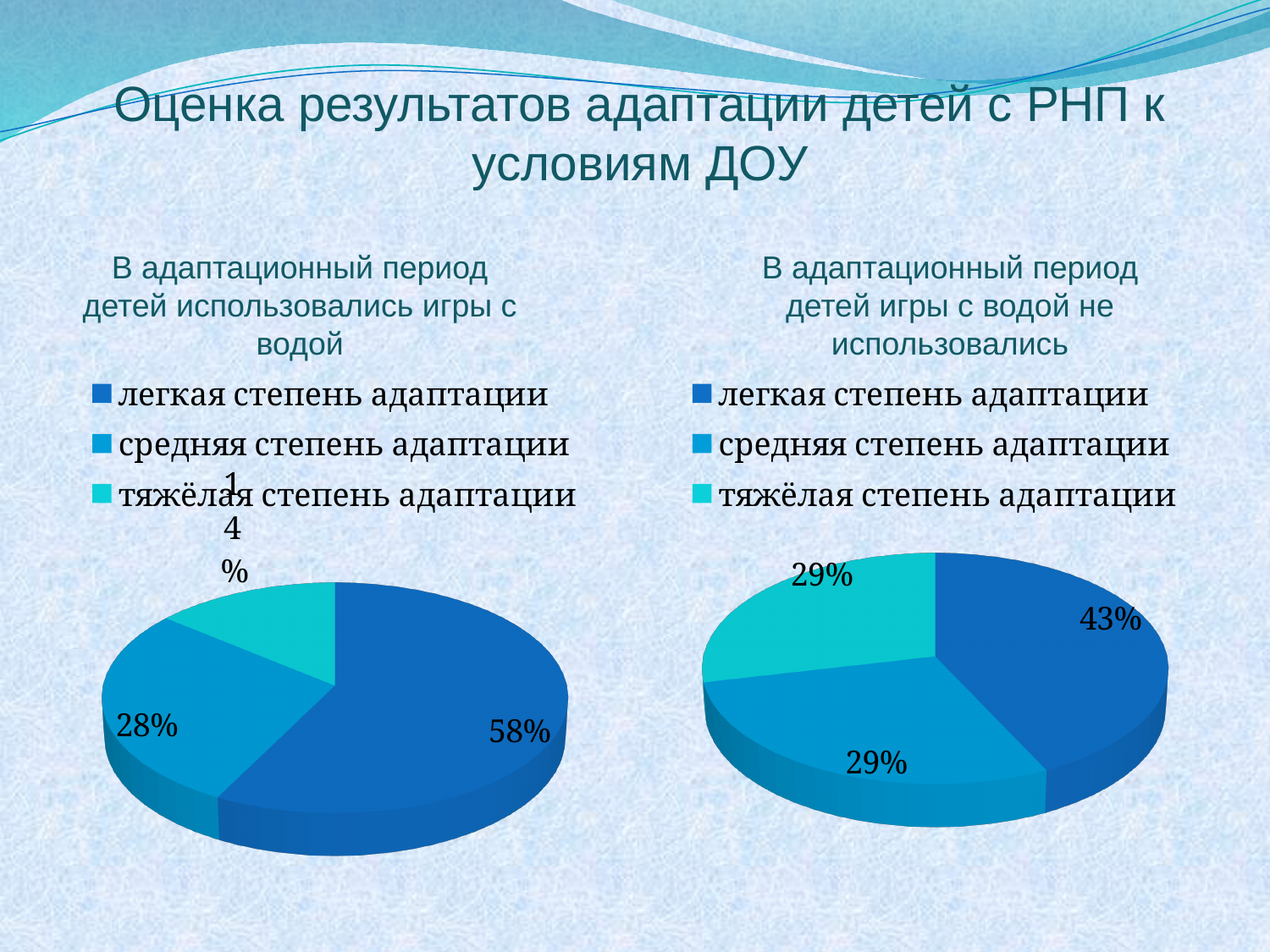
In the left chart (игры с водой использовались), which category has the smallest slice? тяжёлая степень адаптации In the left chart (игры с водой использовались), what share is labelled for тяжёлая степень адаптации? 14% In the right chart (игры с водой не использовались), which category has the largest slice? легкая степень адаптации What is the difference between the легкая степень адаптации share in the left chart and in the right chart? 15% In the left chart (игры с водой использовались), which category has the largest slice? легкая степень адаптации In the left chart (игры с водой использовались), what share is labelled for легкая степень адаптации? 58% In the left chart (игры с водой использовались), what share is labelled for средняя степень адаптации? 28% In the right chart (игры с водой не использовались), what share is labelled for средняя степень адаптации? 29% What type of charts are shown on the slide? Pie charts How many categories does the legend of each pie chart list? 3 In the left chart (игры с водой использовались), what is the difference between the легкая and средняя степень адаптации shares? 30% In the right chart (игры с водой не использовались), what share is labelled for легкая степень адаптации? 43%